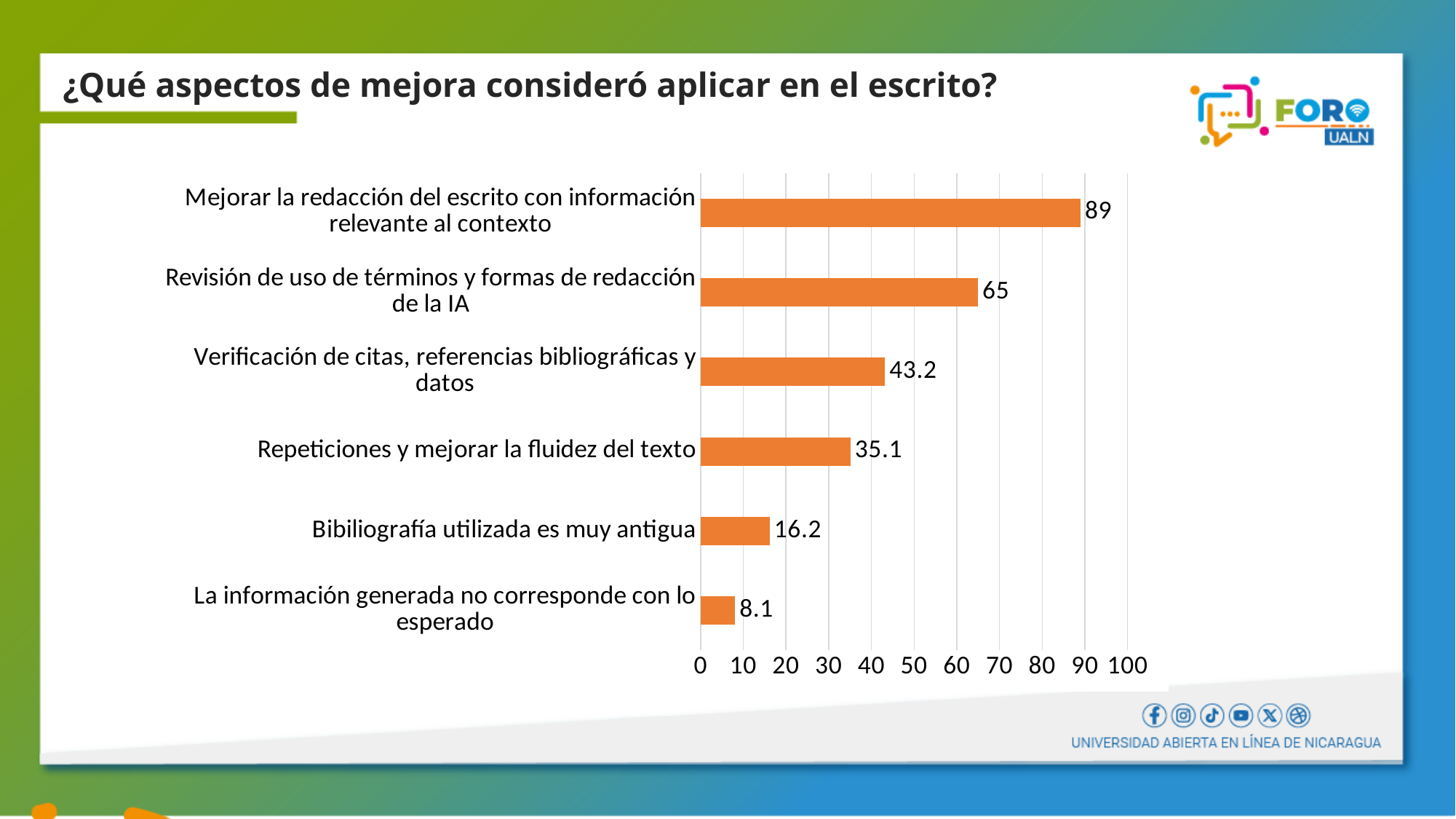
Which category has the lowest value? La información generada no corresponde con lo esperado What is the difference between the values for "Revisión de uso de términos y formas de redacción de la IA" and "Repeticiones y mejorar la fluidez del texto"? 29.9 What is the value for "Mejorar la redacción del escrito con información relevante al contexto"? 89 How many categories are shown in the chart? 6 What is the difference between the highest and lowest values in the chart? 80.9 Is the value for "Revisión de uso de términos y formas de redacción de la IA" greater or less than 50? greater Which is larger: the value for "Verificación de citas, referencias bibliográficas y datos" or the value for "Repeticiones y mejorar la fluidez del texto"? Verificación de citas, referencias bibliográficas y datos What is the value for "Verificación de citas, referencias bibliográficas y datos"? 43.2 Which category has the highest value? Mejorar la redacción del escrito con información relevante al contexto What kind of chart is shown on the slide? Bar chart What is the value for "Bibiliografía utilizada es muy antigua"? 16.2 What is the title of the chart on the slide? ¿Qué aspectos de mejora consideró aplicar en el escrito?